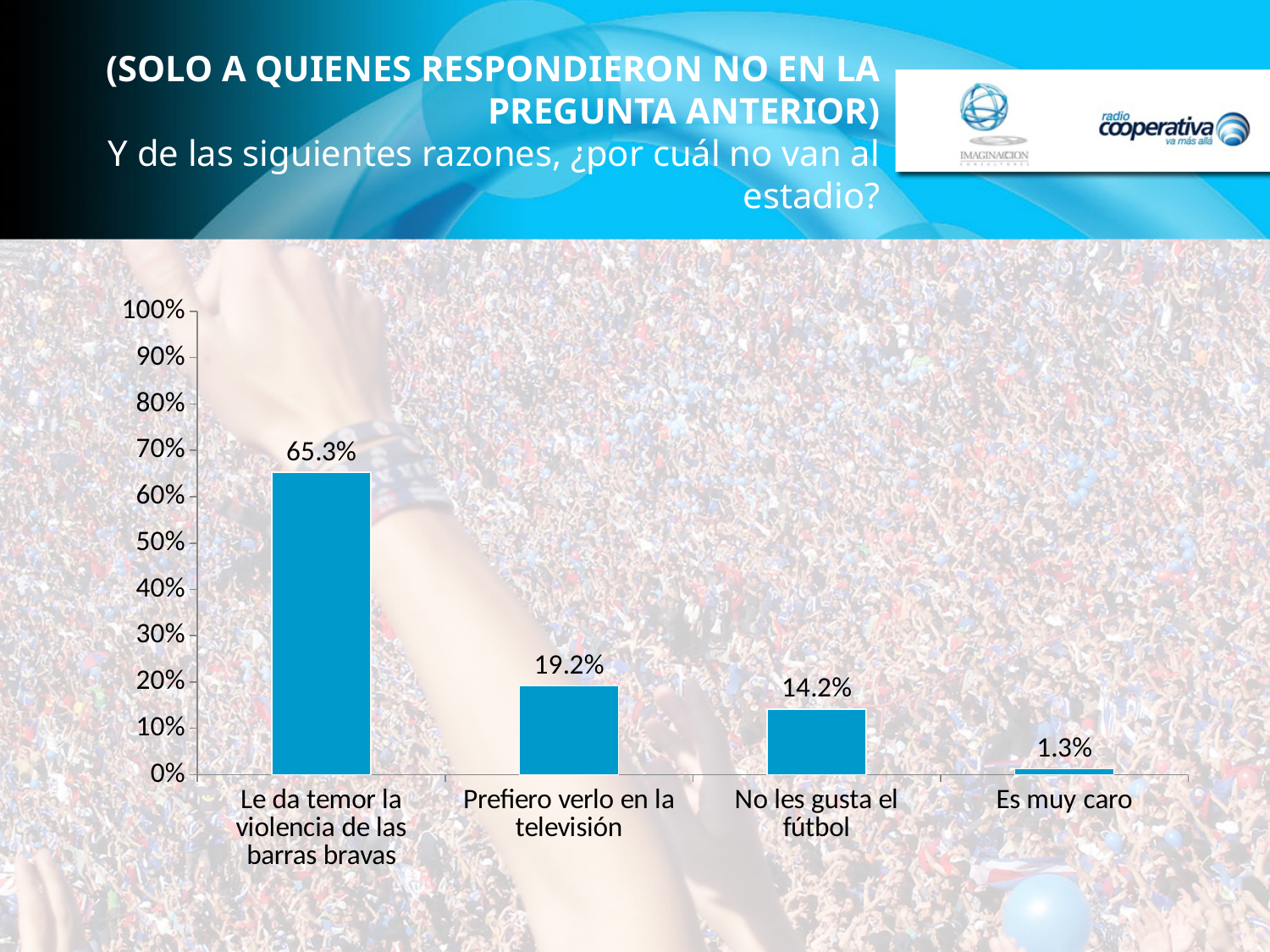
What percentage is shown for "Le da temor la violencia de las barras bravas"? 65.3% What is the value for "No les gusta el fútbol"? 14.2% Which is larger, "No les gusta el fútbol" or "Es muy caro"? No les gusta el fútbol What is the value for "Prefiero verlo en la televisión"? 19.2% What is the difference between "Le da temor la violencia de las barras bravas" and "Prefiero verlo en la televisión"? 46.1% What is the value for "Es muy caro"? 1.3% How many reasons (categories) are shown in the chart? 4 Is the value for "Le da temor la violencia de las barras bravas" greater or less than 60%? greater What is the difference between "Prefiero verlo en la televisión" and "No les gusta el fútbol"? 5.0% Which reason has the lowest percentage? Es muy caro What kind of chart is shown on the slide? Bar chart Which reason has the highest percentage? Le da temor la violencia de las barras bravas